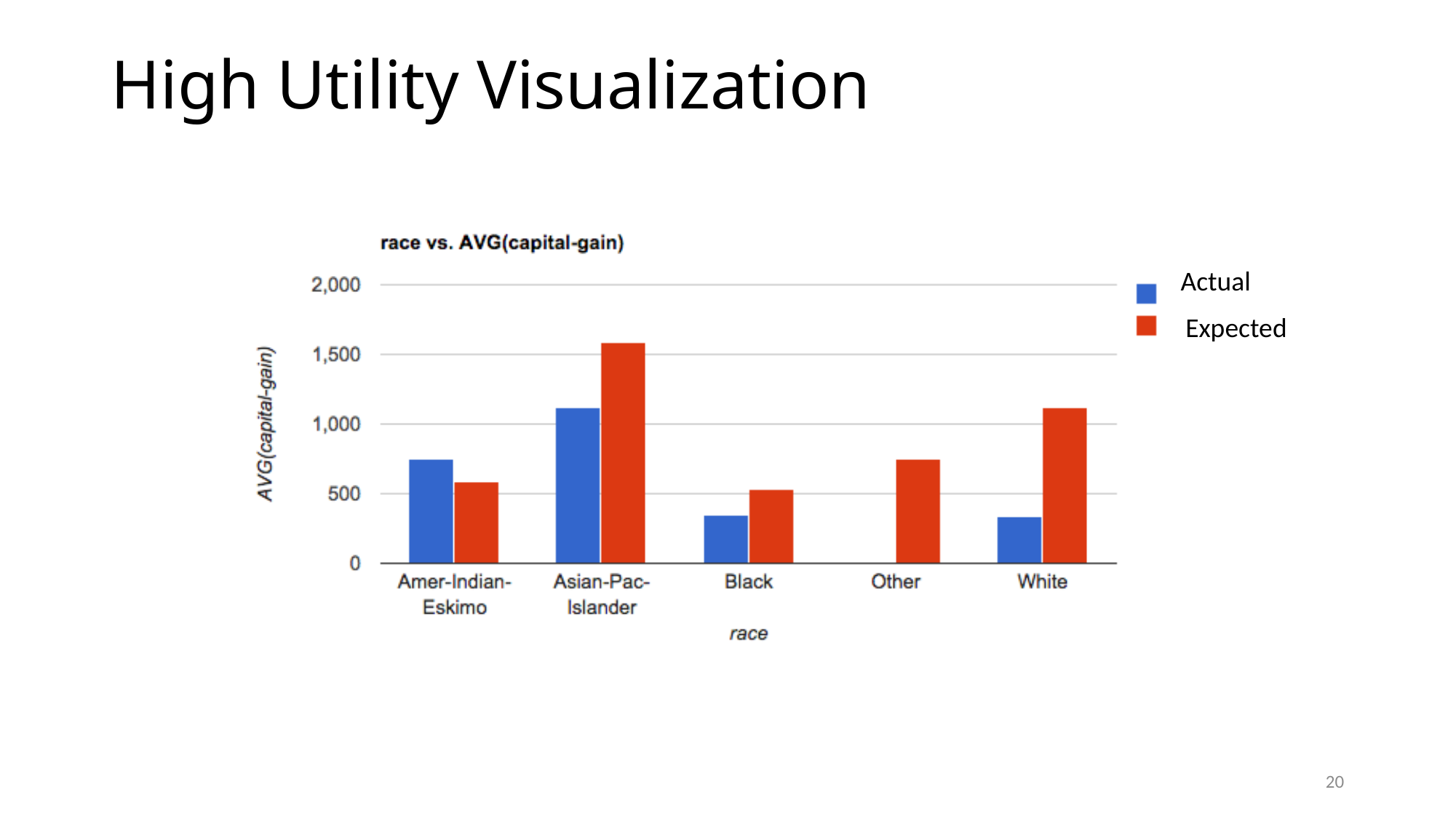
For White, which is larger: the Actual or the Expected value? Expected What kind of chart is shown on the slide? Bar chart Is the Expected value for Asian-Pac-Islander greater or less than 1,500? greater Is the Actual value for Black greater or less than 500? less Which race has the highest Expected value? Asian-Pac-Islander What is the title of the chart? race vs. AVG(capital-gain) How many series does the legend list? 2 Among the races with an Expected bar, which has the lowest Expected value? Black For Amer-Indian-Eskimo, which is larger: the Actual or the Expected value? Actual Which race has the highest Actual value? Asian-Pac-Islander Is the Expected value for White greater or less than 1,000? greater How many race categories are shown on the x axis? 5